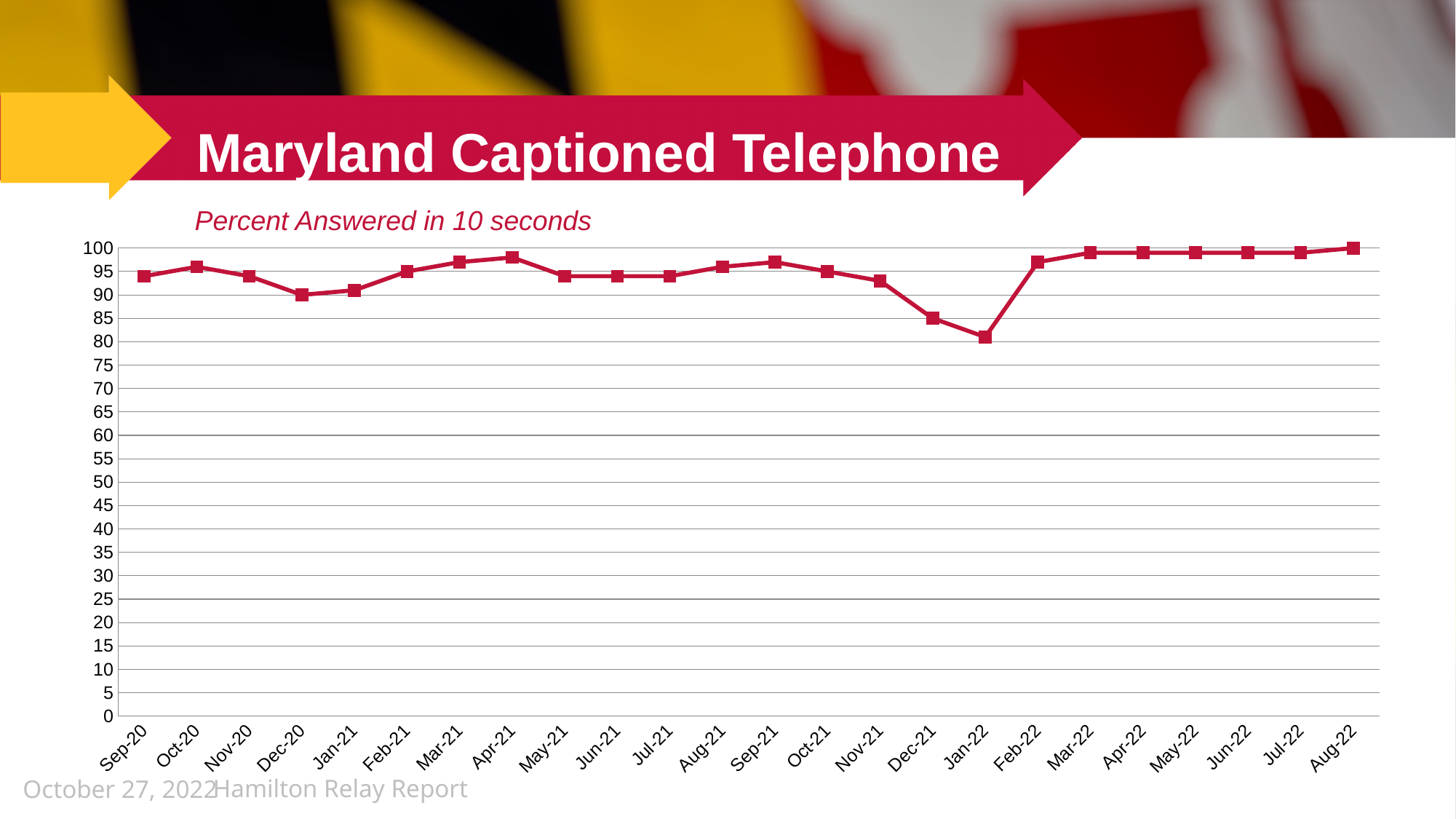
Which month has the higher value, Jan-22 or Feb-22? Feb-22 How many monthly data points are plotted on the chart? 24 What is the percent answered in 10 seconds for Dec-20? 90 Do the values rise or fall from Nov-21 to Jan-22? fall Is the value for Apr-21 greater or less than 95? greater What is the subtitle of the chart? Percent Answered in 10 seconds Is the value for Nov-21 greater or less than 95? less Which month has the higher value, Dec-20 or Apr-21? Apr-21 What kind of chart is shown on the slide? line chart Is the value for Jan-22 greater or less than 85? less What is the percent answered in 10 seconds for Dec-21? 85 Which month has the lowest percent answered in 10 seconds? Jan-22